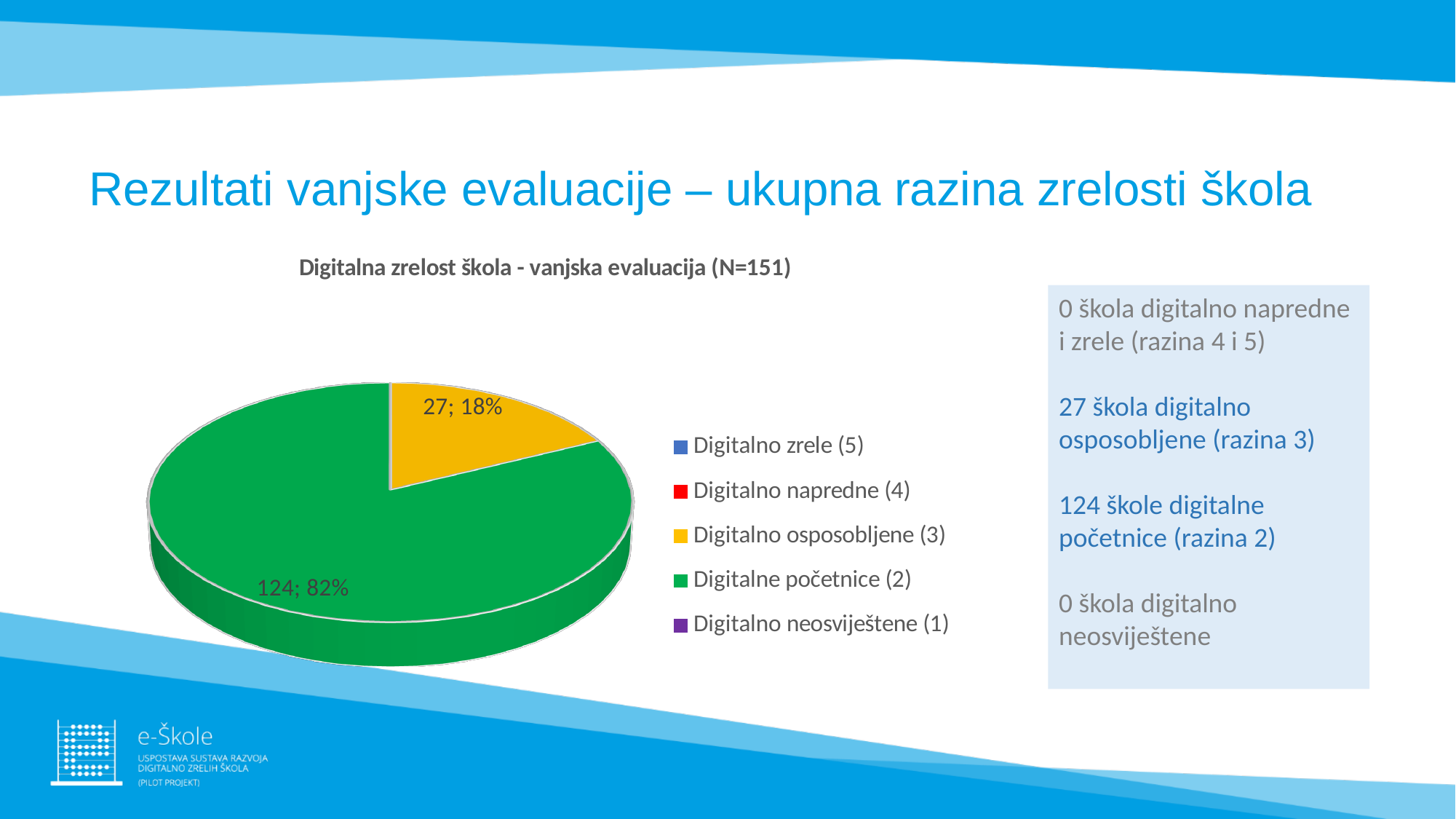
How many schools are in the 'Digitalno osposobljene (3)' slice? 27 What is the title of the chart? Digitalna zrelost škola - vanjska evaluacija (N=151) How many schools are in the 'Digitalne početnice (2)' slice? 124 What kind of chart is shown on the slide? pie chart What percentage share of the pie does 'Digitalno osposobljene (3)' have? 18% What is the difference in number of schools between 'Digitalne početnice (2)' and 'Digitalno osposobljene (3)'? 97 Which category has the largest slice of the pie? Digitalne početnice (2) How many entries does the chart legend list? 5 What colour is the slice for 'Digitalno osposobljene (3)'? yellow Which is larger: the slice for 'Digitalno osposobljene (3)' or the slice for 'Digitalne početnice (2)'? Digitalne početnice (2) How many slices are visible in the pie chart? 2 What percentage share of the pie does 'Digitalne početnice (2)' have? 82%